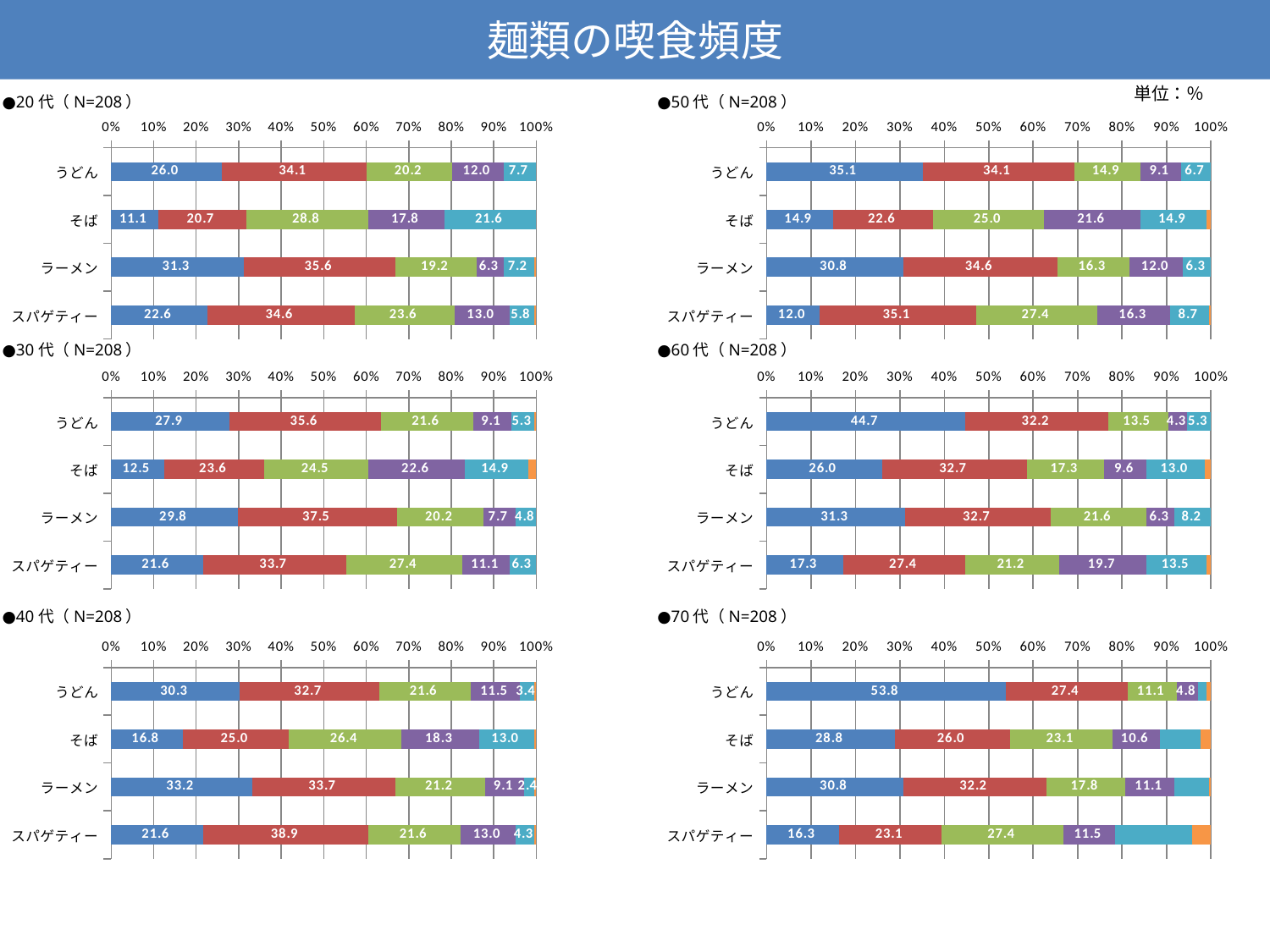
In the ●50代（N=208） chart, what is the value of the purple (fourth) segment for そば? 21.6 In the ●40代（N=208） chart, which category has the smallest blue (first) segment? そば In the ●70代（N=208） chart, is the blue segment for うどん greater or less than 50%? greater What kind of chart is used for the ●60代（N=208） data? Stacked bar chart How many charts are shown on the slide? 6 In the ●50代（N=208） chart, which is larger, the red segment for スパゲティー or the red segment for うどん? スパゲティー In the ●30代（N=208） chart, what is the value of the green (third) segment for スパゲティー? 27.4 In the ●70代（N=208） chart, what is the value of the blue (first) segment for うどん? 53.8 In the ●20代（N=208） chart, which category has the largest blue (first) segment? ラーメン How many categories are shown in the ●20代（N=208） chart? 4 In the ●60代（N=208） chart, what is the value of the red (second) segment for そば? 32.7 In the ●40代（N=208） chart, what is the difference between the blue segment for ラーメン and the blue segment for うどん? 2.9